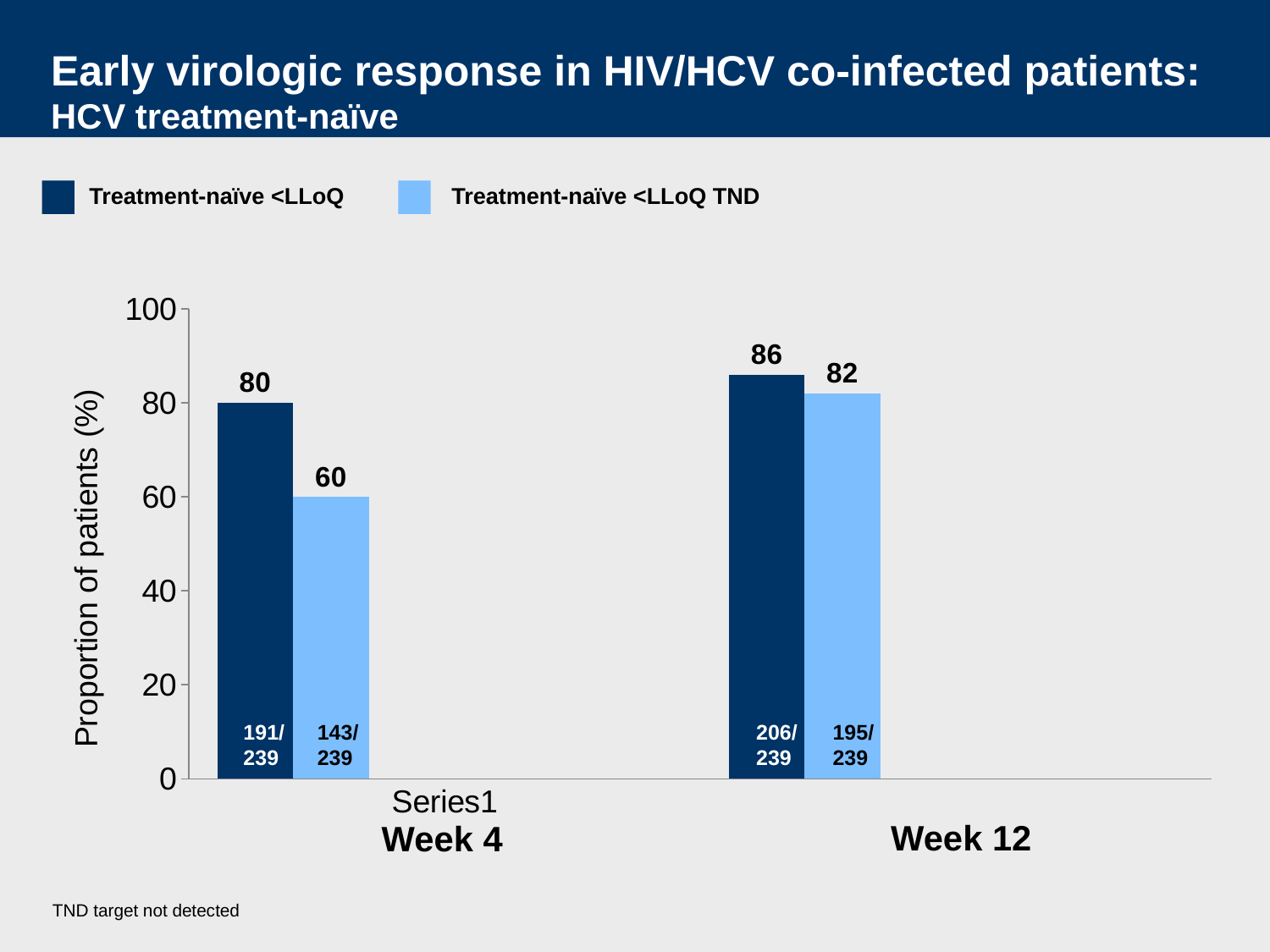
Which bar has the lowest value on the chart? Treatment-naïve <LLoQ TND at Week 4 Which is larger: Treatment-naïve <LLoQ at Week 4 or Treatment-naïve <LLoQ TND at Week 12? Treatment-naïve <LLoQ TND at Week 12 What is the fraction label shown inside the Treatment-naïve <LLoQ bar at Week 12? 206/239 Which bar has the highest value on the chart? Treatment-naïve <LLoQ at Week 12 What is the difference between the Treatment-naïve <LLoQ and Treatment-naïve <LLoQ TND values at Week 4? 20 What is the difference between the Treatment-naïve <LLoQ TND values at Week 12 and Week 4? 22 What is the value for Treatment-naïve <LLoQ TND at Week 4? 60 What is the value for Treatment-naïve <LLoQ TND at Week 12? 82 What is the value for Treatment-naïve <LLoQ at Week 4? 80 What is the value for Treatment-naïve <LLoQ at Week 12? 86 How many series does the legend list? 2 What kind of chart is shown on the slide? Bar chart